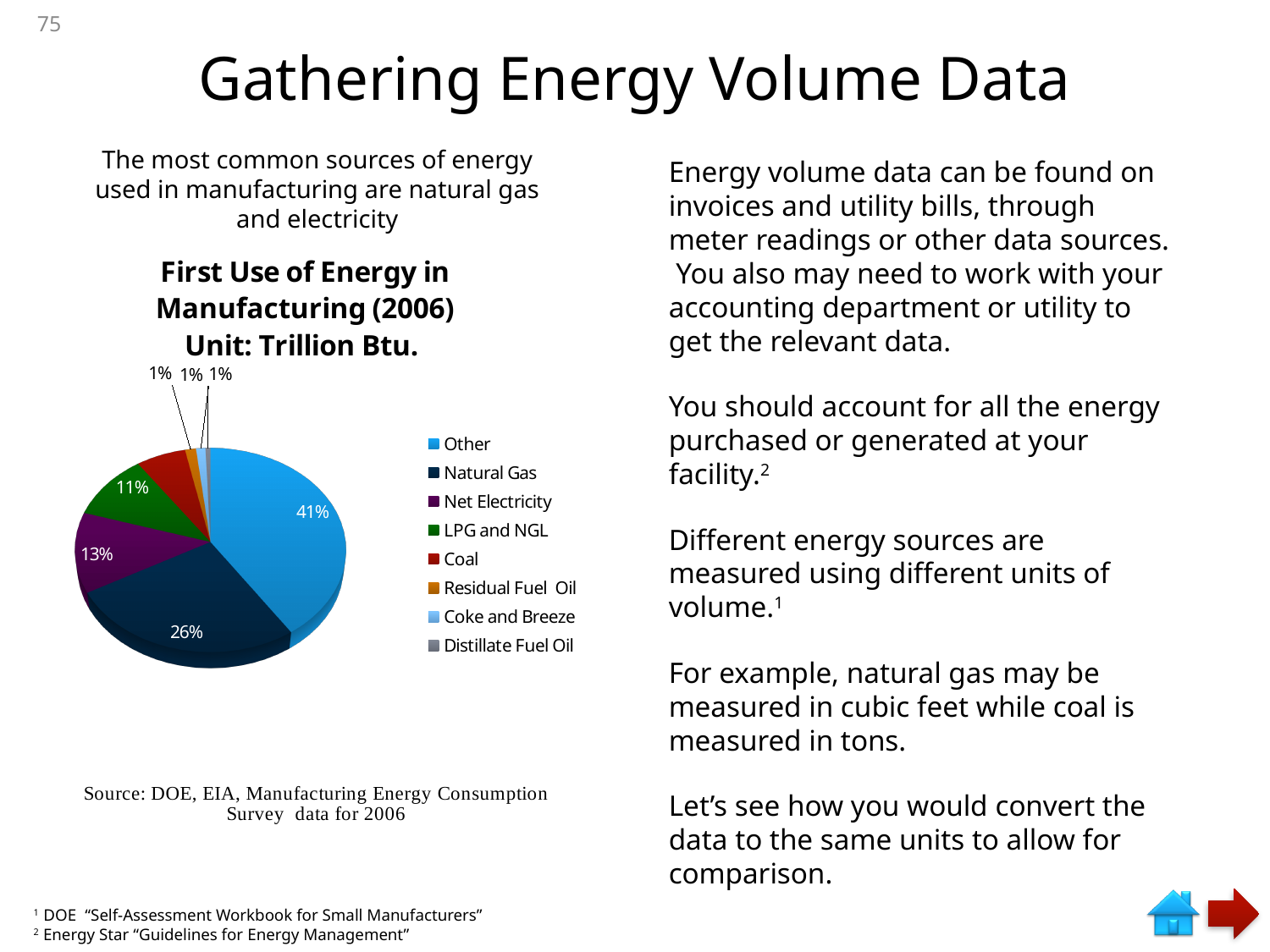
Which category has the largest share of the pie? Other What share of the pie does Natural Gas account for? 26% Which is larger, the share for Natural Gas or the share for Net Electricity? Natural Gas What kind of chart is shown on the slide? Pie chart Which is larger, the share for Other or the share for Natural Gas? Other What share of the pie does LPG and NGL account for? 11% What share of the pie does Other account for? 41% How many categories does the chart's legend list? 8 What is the difference in percentage points between the Net Electricity share and the LPG and NGL share? 2 What is the title of the chart? First Use of Energy in Manufacturing (2006) Unit: Trillion Btu. What is the difference in percentage points between the Other share and the Natural Gas share? 15